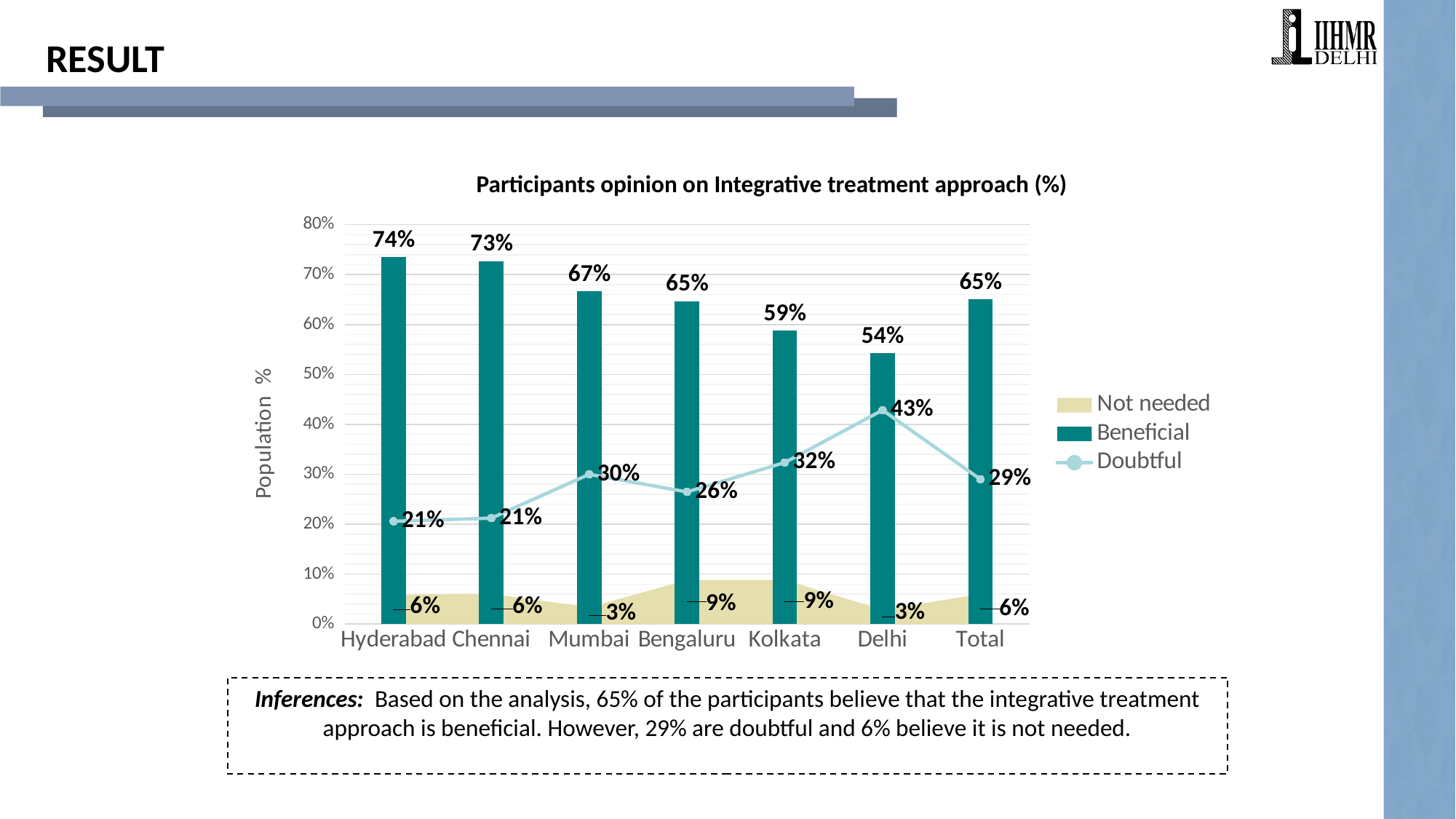
Which category has the highest Doubtful value? Delhi How many series does the legend list? 3 Which category has the highest Beneficial value? Hyderabad How many categories are shown on the x axis? 7 What is the Not needed value for Kolkata? 9% Which is larger, the Doubtful value for Mumbai or the Doubtful value for Bengaluru? Mumbai What is the Doubtful value for Delhi? 43% What is the Beneficial value for Hyderabad? 74% What is the y-axis label of the chart? Population % What is the title of the chart? Participants opinion on Integrative treatment approach (%) What is the difference between the Beneficial values for Hyderabad and Delhi? 20% Which category has the lowest Beneficial value? Delhi